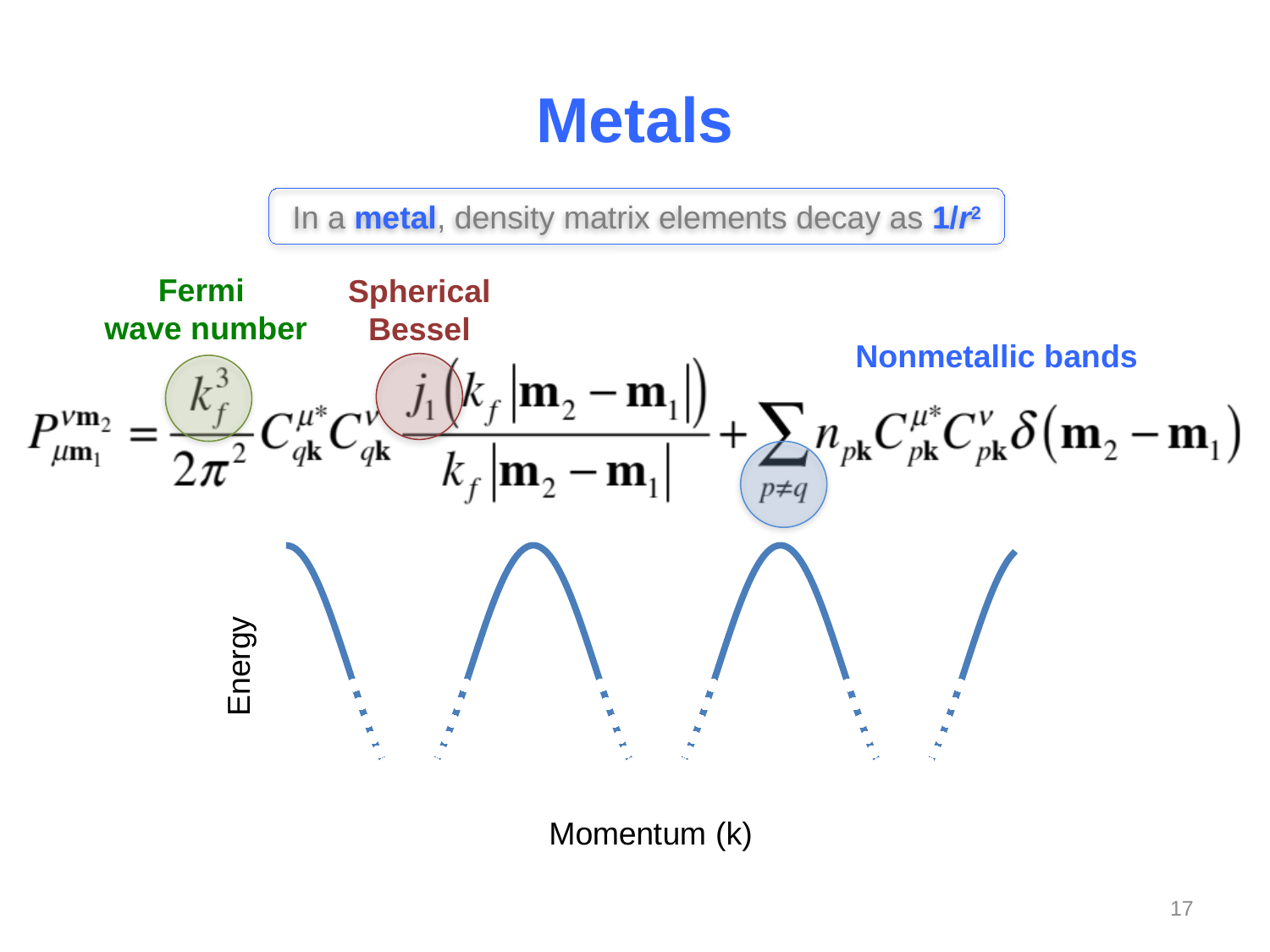
How many full peaks (maxima) does the solid curve show between the left and right edges of the chart? 2 What is the label on the vertical axis of the chart? Energy What kind of chart is shown below the equation on the slide? line chart Does the energy curve rise steadily, fall steadily, or oscillate along the momentum axis? oscillate What is the label on the horizontal axis of the chart? Momentum (k) How many valleys (minima) are drawn with dashed lines in the chart? 3